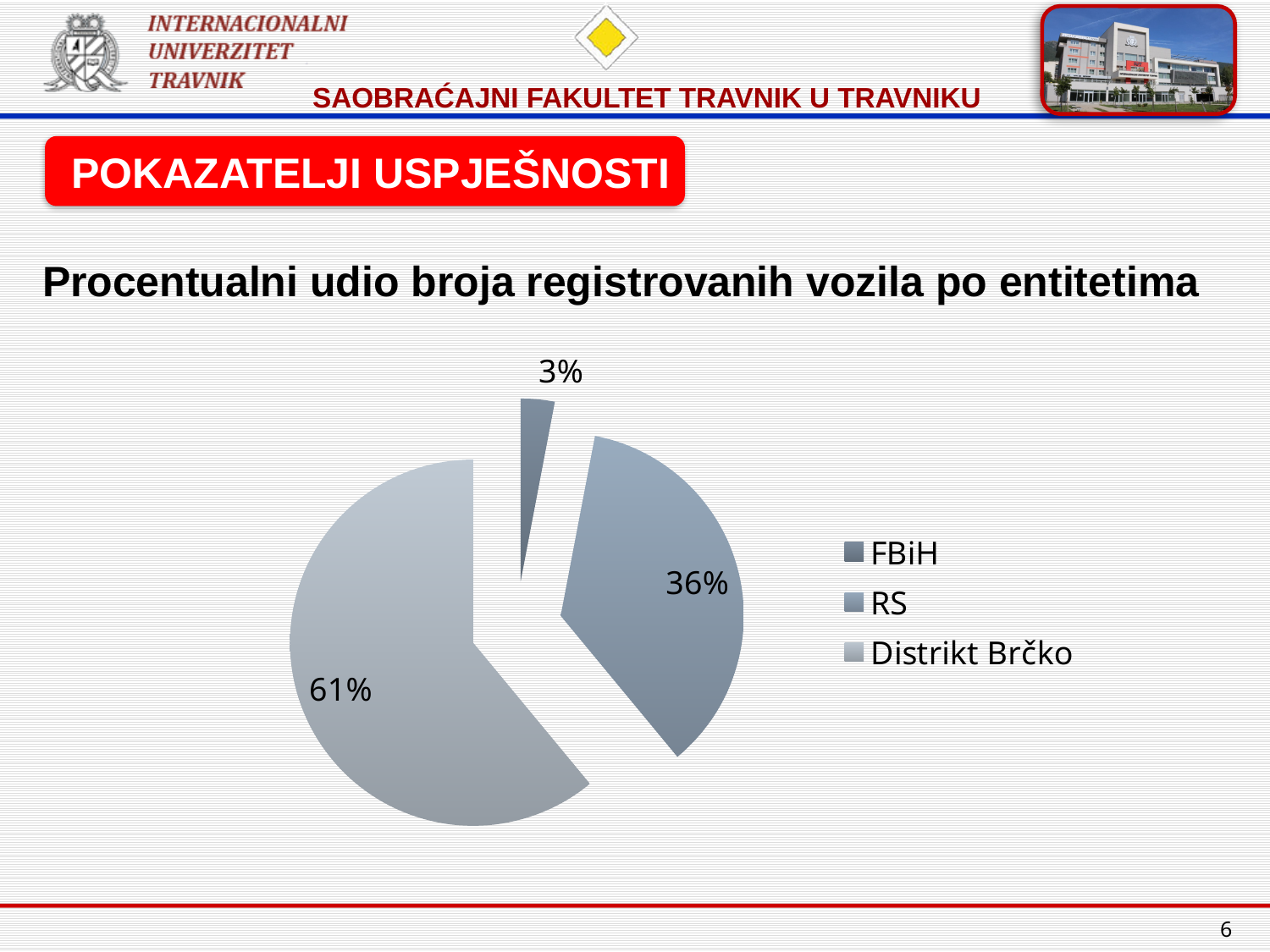
What is the title of the chart? Procentualni udio broja registrovanih vozila po entitetima What share of the pie is labelled for Distrikt Brčko? 61% How many slices does the pie chart have? 3 How many entries does the chart legend list? 3 What is the difference in percentage points between the Distrikt Brčko slice and the RS slice? 25 Which slice is larger, RS or FBiH? RS Which legend entry is listed first in the chart legend? FBiH What share of the pie is labelled for RS? 36% Which category has the smallest slice of the pie? FBiH What share of the pie is labelled for FBiH? 3% What kind of chart is shown on the slide? pie chart Which category has the largest slice of the pie? Distrikt Brčko